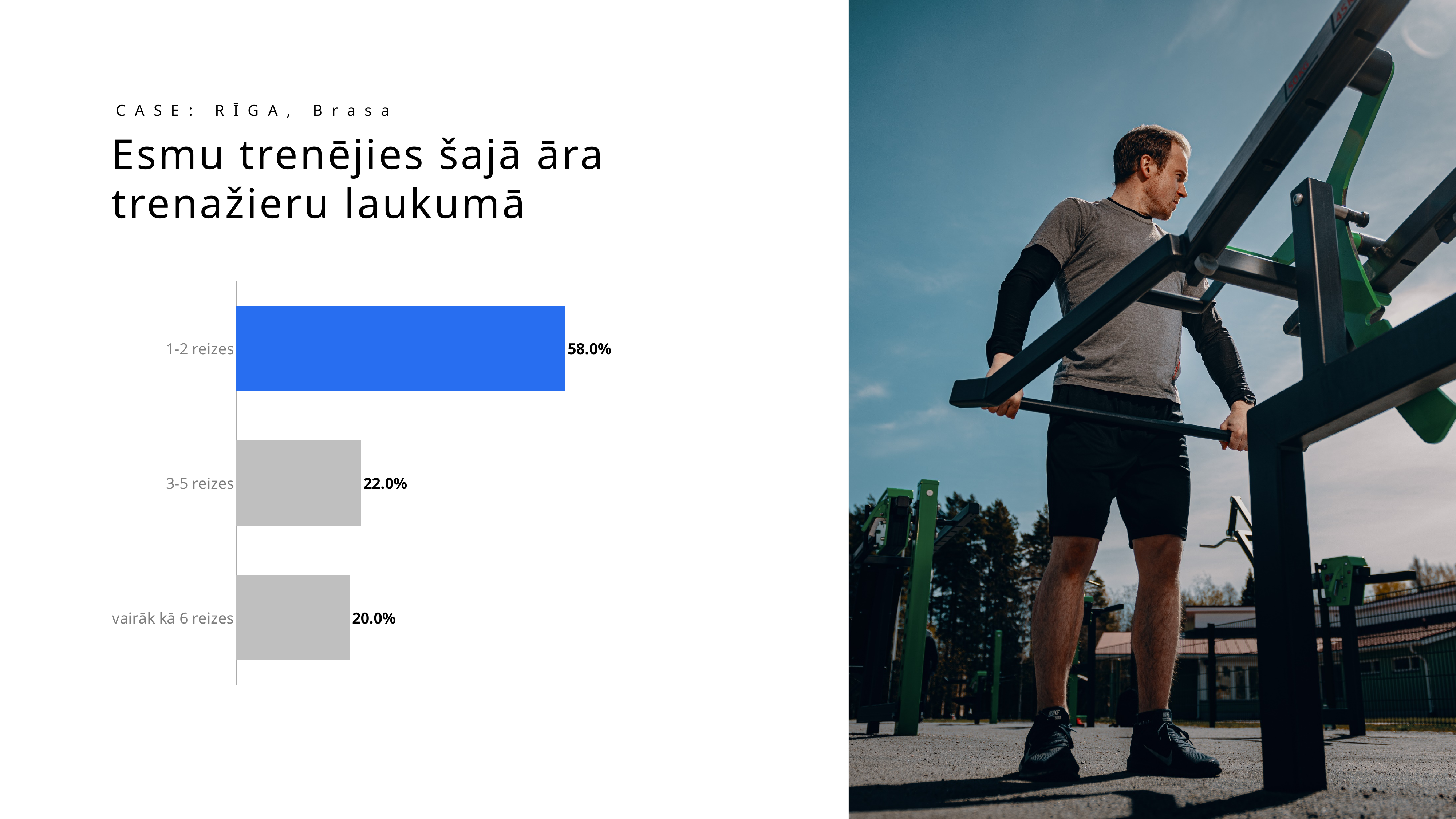
What is the value for "3-5 reizes"? 22.0% Which is larger, the value for "1-2 reizes" or the value for "vairāk kā 6 reizes"? 1-2 reizes What is the difference between the values for "3-5 reizes" and "vairāk kā 6 reizes"? 2.0% Which category has the highest value? 1-2 reizes What kind of chart is shown on the slide? bar chart What is the value for "1-2 reizes"? 58.0% Which category has the lowest value? vairāk kā 6 reizes Which bar is coloured blue rather than grey? 1-2 reizes What is the title of the chart on the slide? Esmu trenējies šajā āra trenažieru laukumā How many categories are shown in the chart? 3 What is the difference between the values for "1-2 reizes" and "3-5 reizes"? 36.0% What is the value for "vairāk kā 6 reizes"? 20.0%